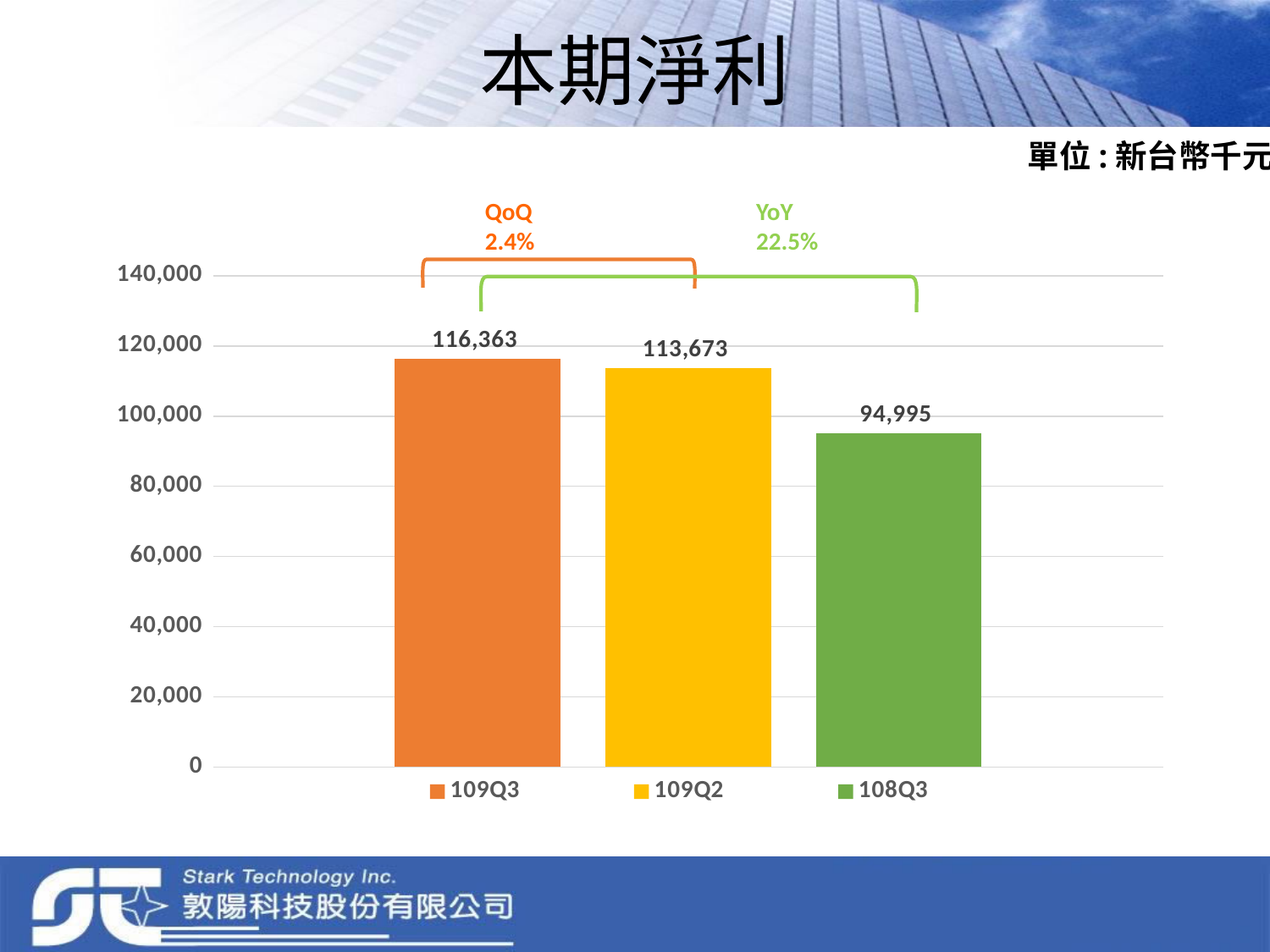
What kind of chart is shown on the slide? bar chart What is the value for 108Q3? 94,995 Is the value for 108Q3 greater or less than 100,000? less Which period has the lowest value? 108Q3 What QoQ percentage change is shown above the chart? 2.4% What is the value for 109Q2? 113,673 What is the difference between the values for 109Q3 and 108Q3? 21,368 What is the value for 109Q3? 116,363 Which period has the highest value? 109Q3 How many bars are shown in the chart? 3 Which is larger, the value for 109Q2 or the value for 108Q3? 109Q2 What is the difference between the values for 109Q3 and 109Q2? 2,690